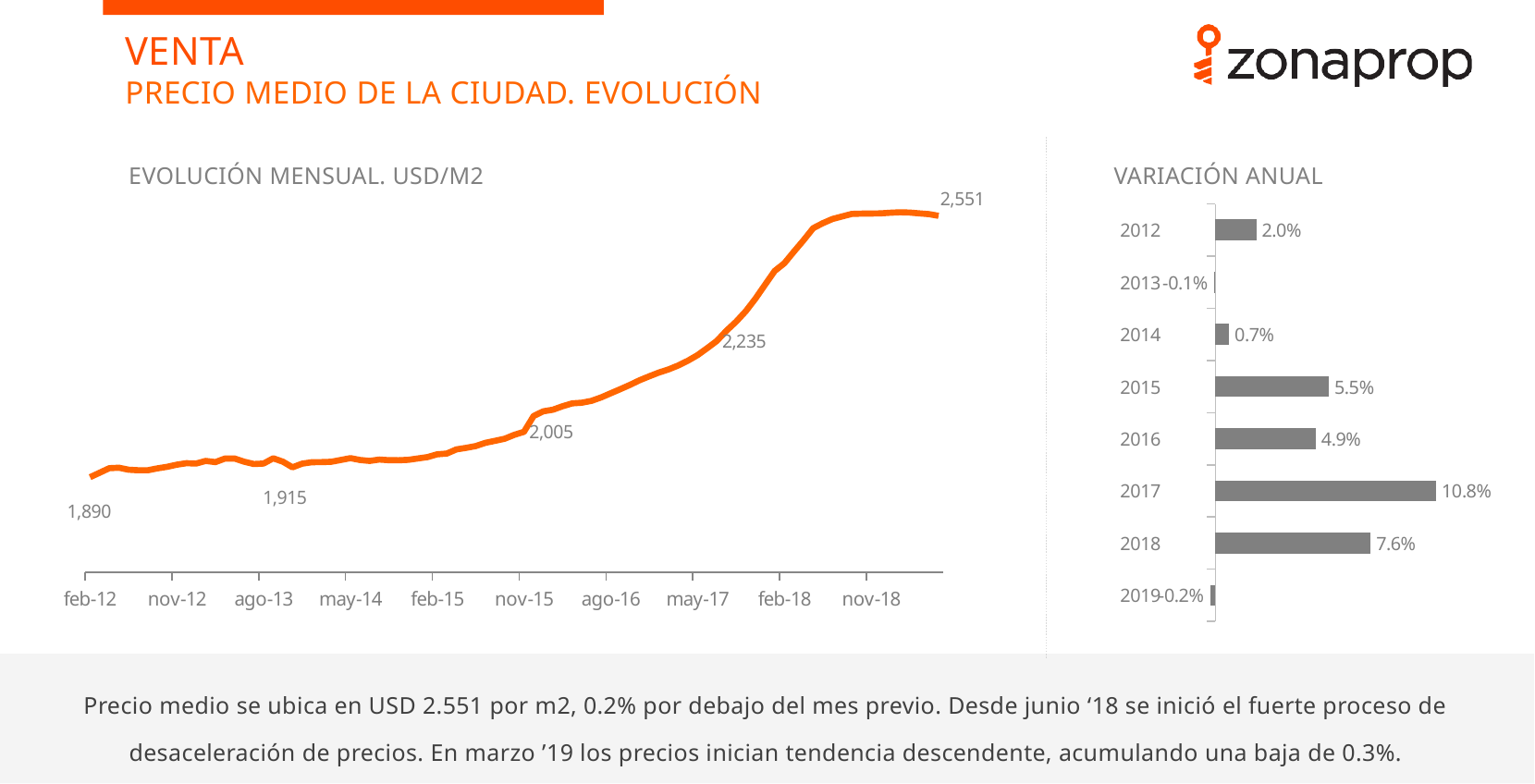
In the VARIACIÓN ANUAL chart, which year has the lowest value? 2019 In the VARIACIÓN ANUAL chart, which year has the highest value? 2017 In the VARIACIÓN ANUAL chart, what is the difference between the values for 2017 and 2018? 3.2 percentage points What kind of chart is the VARIACIÓN ANUAL chart? Bar chart In the EVOLUCIÓN MENSUAL. USD/M2 chart, what is the value labelled at the end of the line? 2,551 In the VARIACIÓN ANUAL chart, which is larger, the value for 2015 or the value for 2016? 2015 In the EVOLUCIÓN MENSUAL. USD/M2 chart, what is the value labelled at the start of the line (feb-12)? 1,890 In the VARIACIÓN ANUAL chart, what is the value for 2013? -0.1% What kind of chart is the EVOLUCIÓN MENSUAL. USD/M2 chart? Line chart In the EVOLUCIÓN MENSUAL. USD/M2 chart, do the values generally rise or fall from feb-12 to nov-18? Rise In the VARIACIÓN ANUAL chart, what is the value for 2017? 10.8% How many years are shown in the VARIACIÓN ANUAL chart? 8